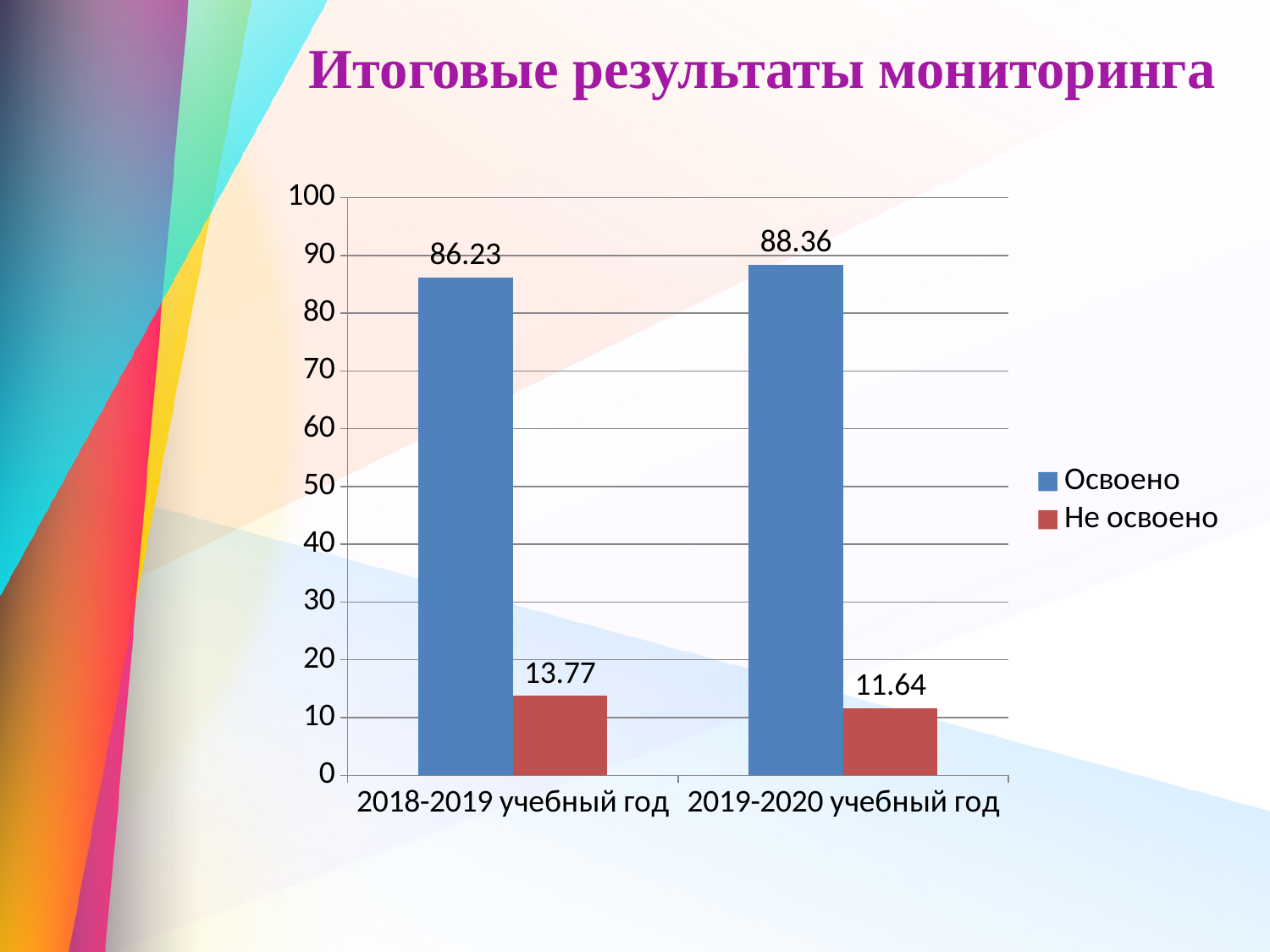
What is the value of Не освоено for 2018-2019 учебный год? 13.77 What is the value of Освоено for 2018-2019 учебный год? 86.23 Is the Освоено value for 2019-2020 учебный год greater or less than 80? greater What is the value of Не освоено for 2019-2020 учебный год? 11.64 What kind of chart is shown on the slide? bar chart How many categories are shown on the x axis? 2 How many series does the legend list? 2 In which year is the Не освоено value lowest? 2019-2020 учебный год What is the difference between the Освоено values for 2019-2020 and 2018-2019? 2.13 Which is larger: Не освоено in 2018-2019 or Не освоено in 2019-2020? 2018-2019 учебный год What is the title of the slide? Итоговые результаты мониторинга In which year is the Освоено value highest? 2019-2020 учебный год